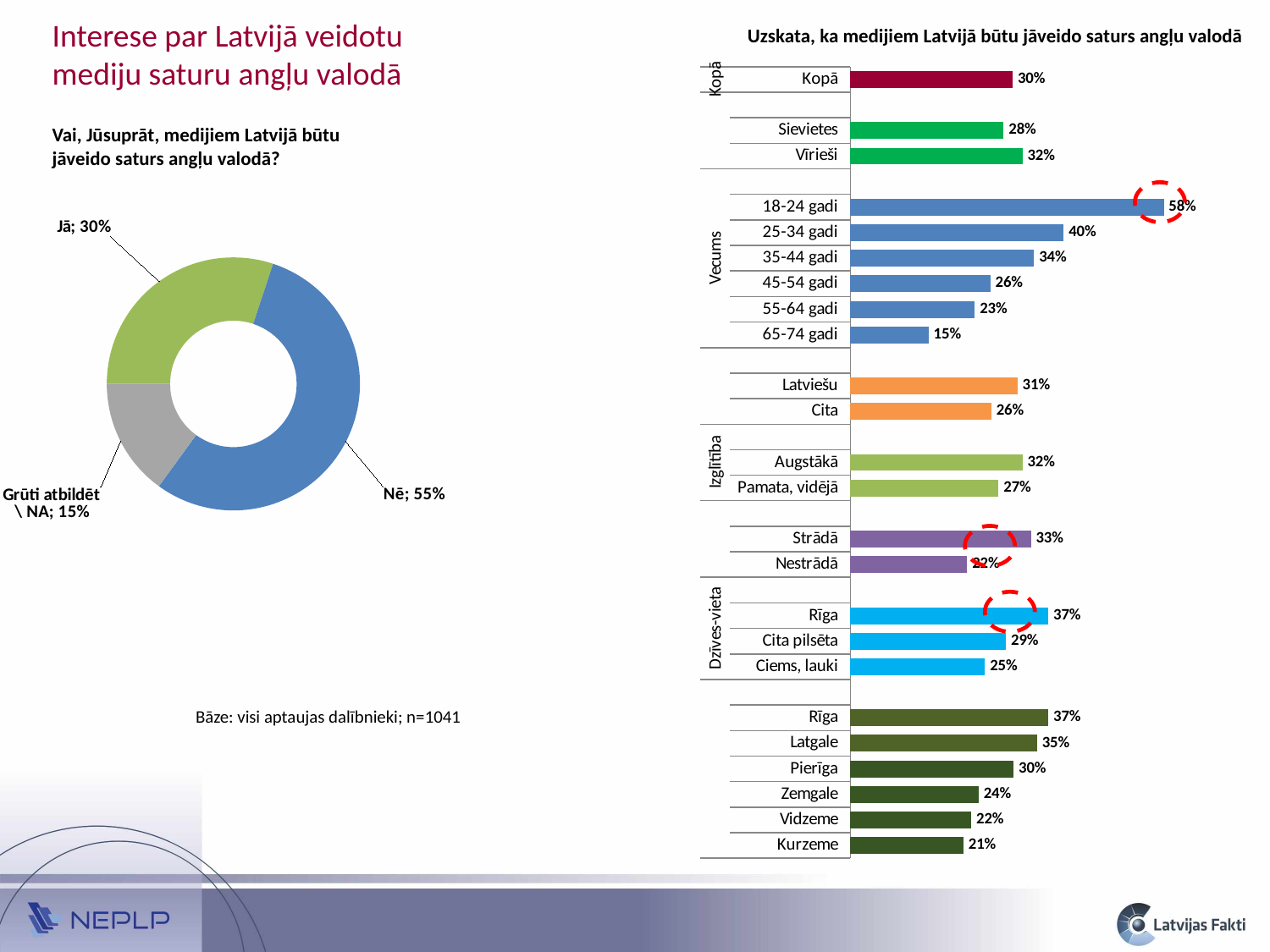
What kind of chart is the chart on the left of the slide? Pie (donut) chart In the bar chart on the right, do the values fall from 18-24 gadi to 65-74 gadi? Yes, they fall In the bar chart on the right, what is the value for Kopā? 30% In the bar chart on the right, what is the difference between Vīrieši and Sievietes? 4% In the bar chart on the right, which age group has the lowest value? 65-74 gadi In the donut chart on the left, what share of respondents answered "Jā"? 30% In the donut chart on the left, how many slices are there? 3 In the bar chart on the right, which is larger, Latgale or Kurzeme? Latgale What kind of chart is the chart on the right of the slide? Bar chart In the bar chart on the right, which category has the highest value overall? 18-24 gadi In the donut chart on the left, what share of respondents answered "Nē"? 55% In the bar chart on the right, what is the value for 18-24 gadi? 58%